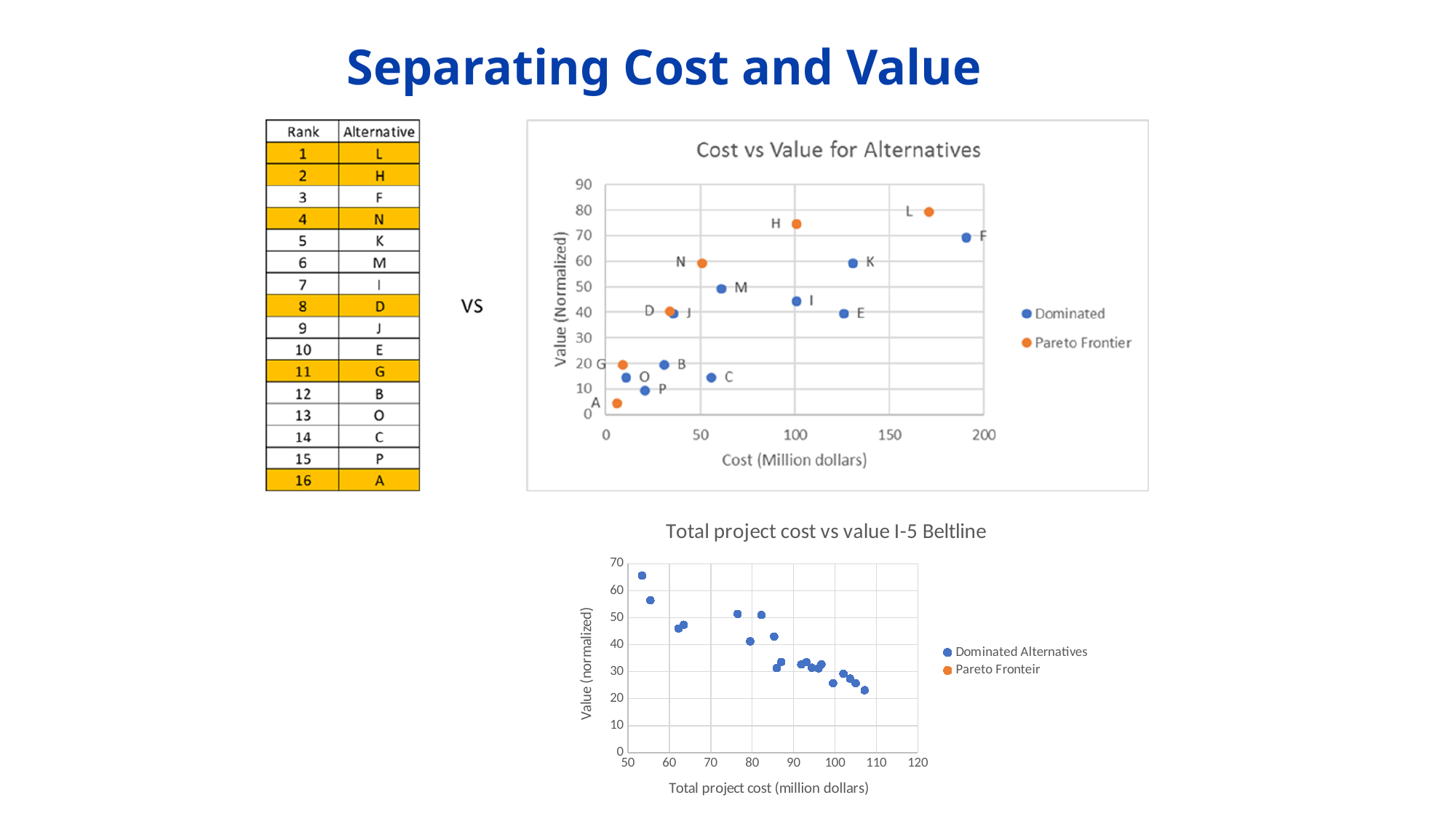
In the 'Cost vs Value for Alternatives' chart, how many series does the legend list? 2 What kind of chart is the 'Cost vs Value for Alternatives' chart? Scatter chart In the 'Cost vs Value for Alternatives' chart, is the value for alternative E greater or less than 50? less In the 'Cost vs Value for Alternatives' chart, which has the higher value, alternative L or alternative E? L In the 'Cost vs Value for Alternatives' chart, is the cost for alternative F greater or less than 150 million dollars? greater In the 'Cost vs Value for Alternatives' chart, which alternative has the highest cost? F In the 'Total project cost vs value I-5 Beltline' chart, how many series does the legend list? 2 In the 'Cost vs Value for Alternatives' chart, which alternative has the lowest value (normalized)? A In the 'Cost vs Value for Alternatives' chart, which alternative has the highest value (normalized)? L In the 'Total project cost vs value I-5 Beltline' chart, do values generally rise or fall as total project cost increases? fall In the 'Cost vs Value for Alternatives' chart, is the value for alternative L greater or less than 70? greater In the 'Cost vs Value for Alternatives' chart, which series are the orange points labelled as in the legend? Pareto Frontier